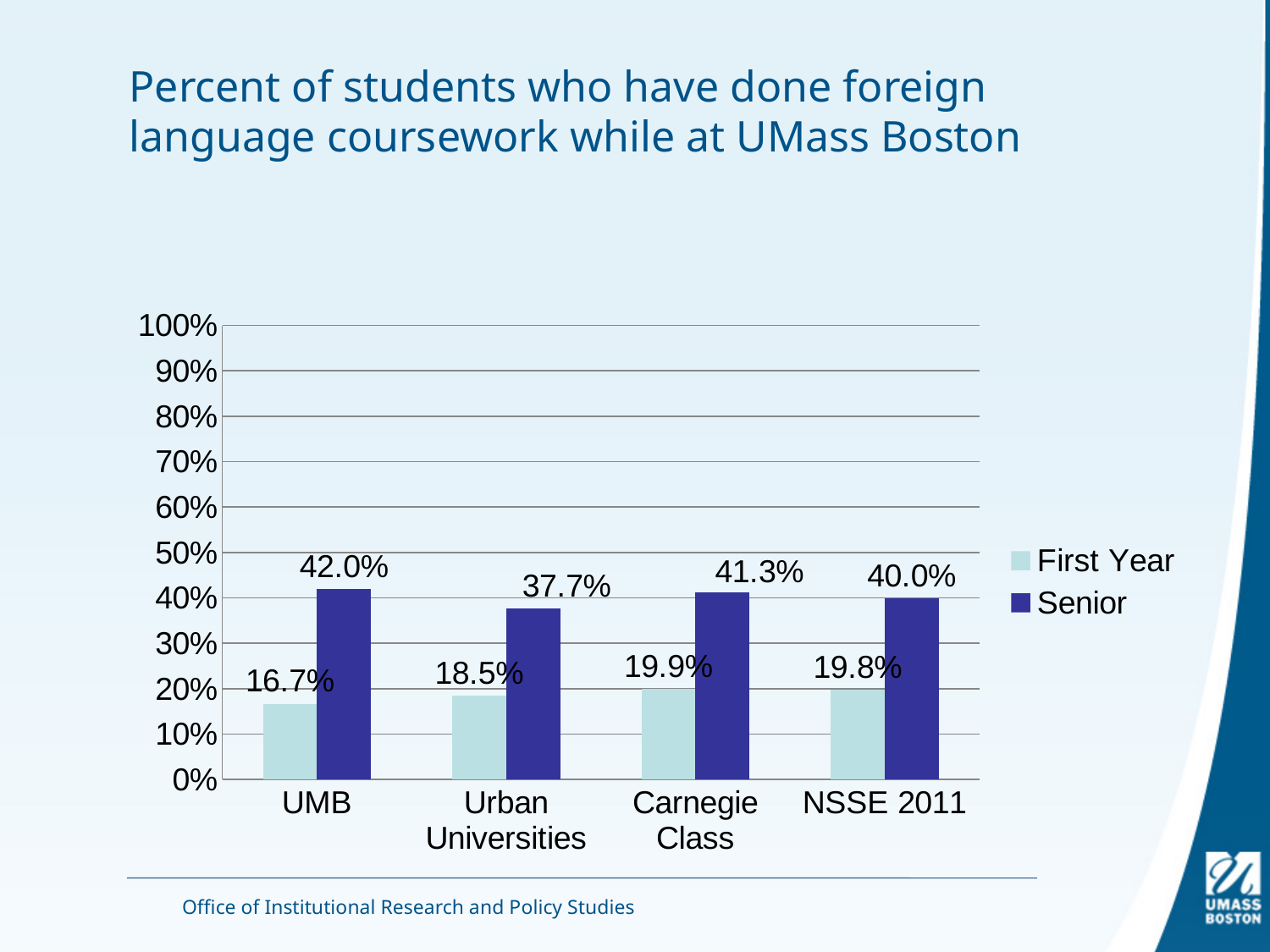
What is the difference between the Senior and First Year values for UMB? 25.3% Which category has the lowest First Year value? UMB How many categories are shown on the x axis? 4 What are the two series listed in the legend? First Year and Senior What is the First Year value for Urban Universities? 18.5% What kind of chart is shown on the slide? Bar chart How many series does the legend list? 2 Which category has the highest Senior value? UMB What is the difference between the Senior values for UMB and Urban Universities? 4.3% Which is larger, the Senior value for Carnegie Class or the Senior value for Urban Universities? Carnegie Class What is the Senior value for UMB? 42.0% What is the Senior value for NSSE 2011? 40.0%